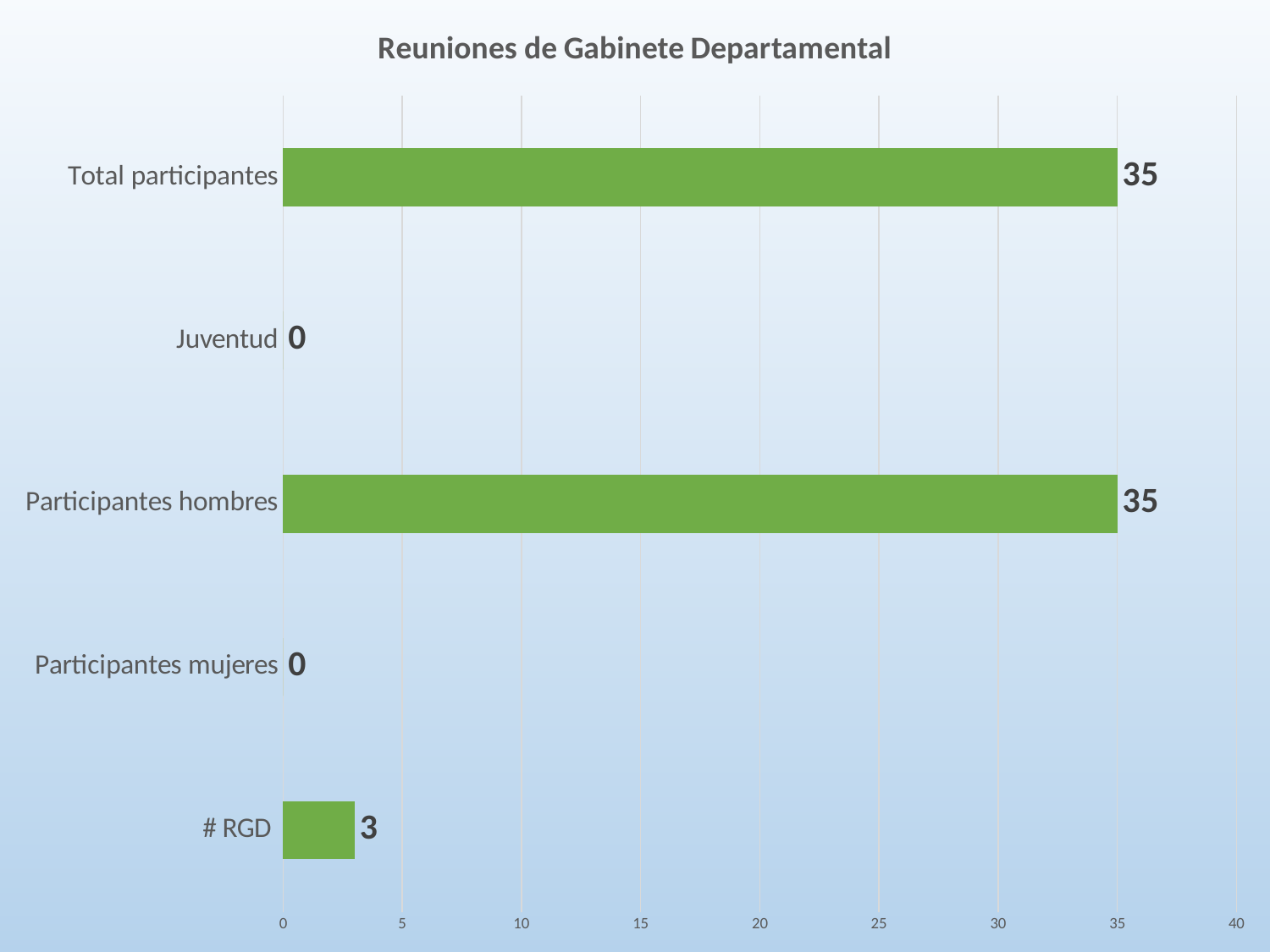
What is the value for Participantes mujeres? 0 What kind of chart is this? bar chart What is the value for Juventud? 0 Is the value for Total participantes greater or less than 30? greater What is the difference between Participantes hombres and # RGD? 32 What is the title of the chart? Reuniones de Gabinete Departamental What is the difference between Total participantes and Participantes hombres? 0 What is the value for Total participantes? 35 What is the value for Participantes hombres? 35 How many categories are shown on the chart? 5 What is the value for # RGD? 3 Which is larger, Participantes hombres or Participantes mujeres? Participantes hombres